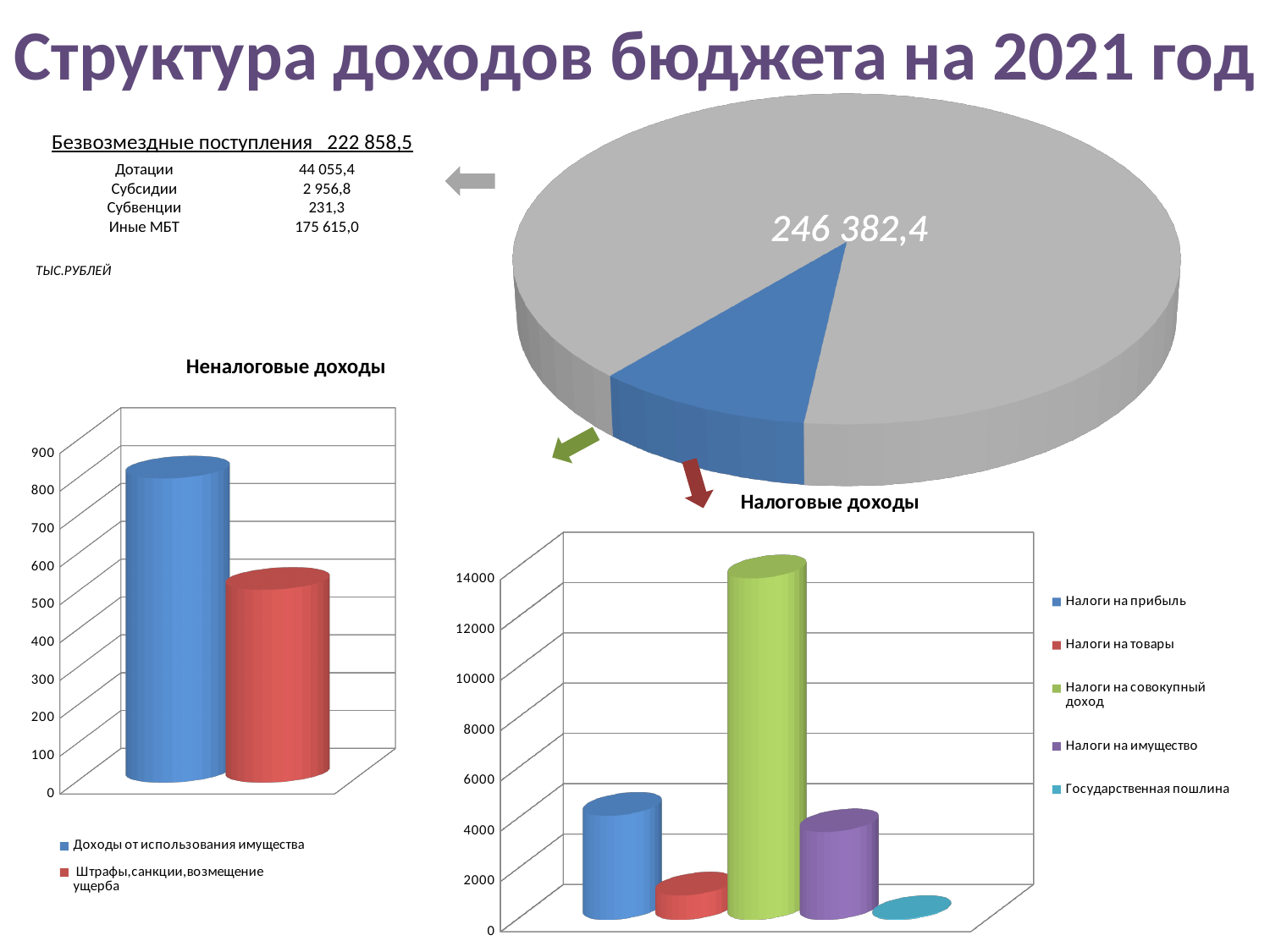
In the 'Налоговые доходы' chart, which series has the highest value? Налоги на совокупный доход What kind of chart is the 'Неналоговые доходы' chart? bar chart In the 'Неналоговые доходы' chart, is the value for 'Доходы от использования имущества' greater or less than 600? greater In the 'Налоговые доходы' chart, which series has the lowest value? Государственная пошлина In the top-right pie chart, what value is printed on the chart? 246 382,4 In the 'Неналоговые доходы' chart, which series has the highest value? Доходы от использования имущества In the 'Налоговые доходы' chart, is the value for 'Налоги на совокупный доход' greater or less than 12000? greater In the 'Неналоговые доходы' chart, is the value for 'Штрафы,санкции,возмещение ущерба' greater or less than 700? less What kind of chart is the top-right chart labelled 246 382,4? pie chart How many series does the legend of the 'Неналоговые доходы' chart list? 2 How many series does the legend of the 'Налоговые доходы' chart list? 5